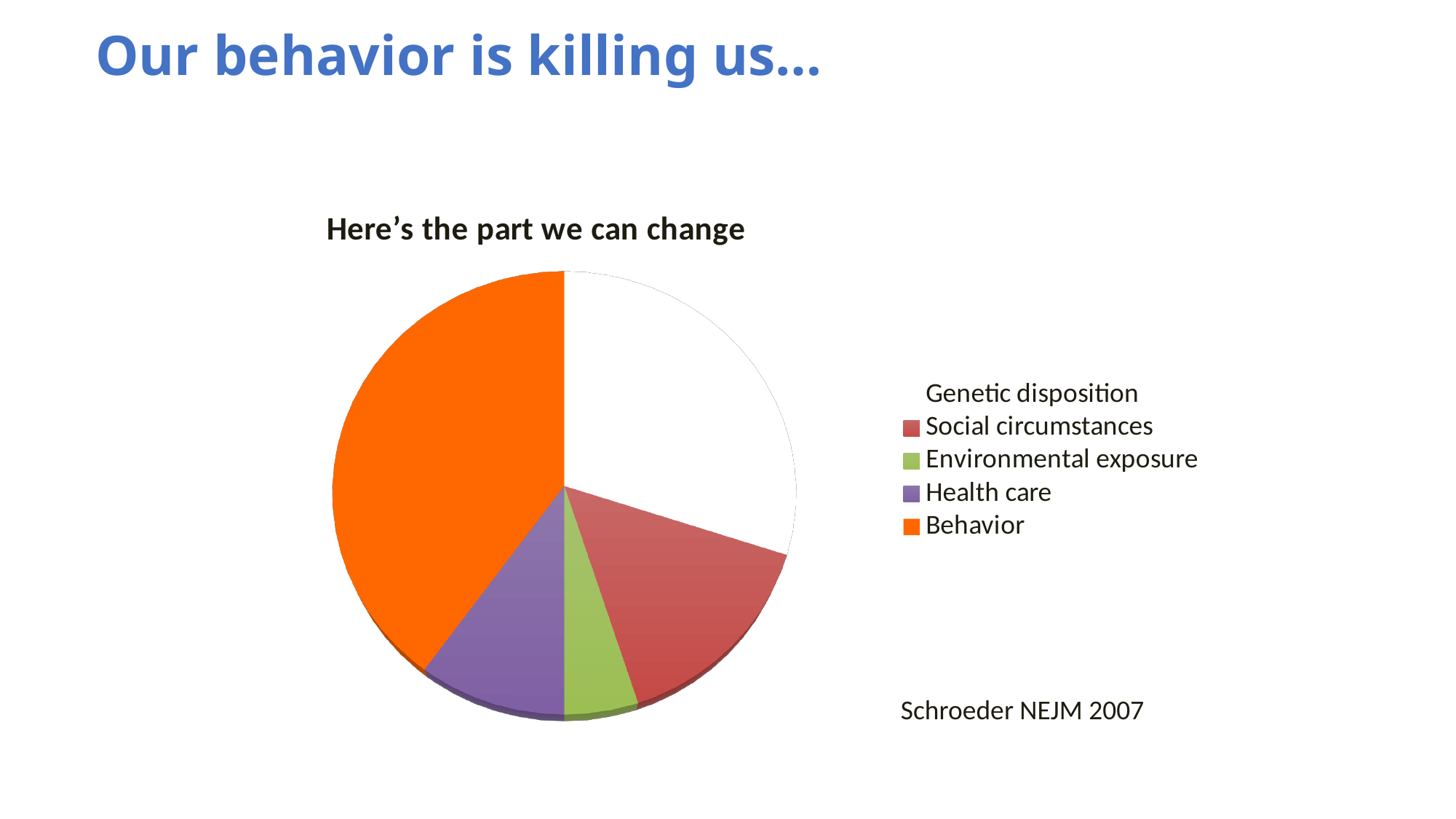
Which category has the smallest slice of the pie? Environmental exposure Which slice is larger, Social circumstances or Environmental exposure? Social circumstances Which category has the largest slice of the pie? Behavior What kind of chart is shown on the slide? Pie chart What is the title of the chart? Here's the part we can change What colour is the Behavior slice in the pie chart? Orange Which slice is larger, Genetic disposition or Social circumstances? Genetic disposition Which slice is larger, Health care or Environmental exposure? Health care How many categories does the pie chart have? 5 How many entries does the legend list? 5